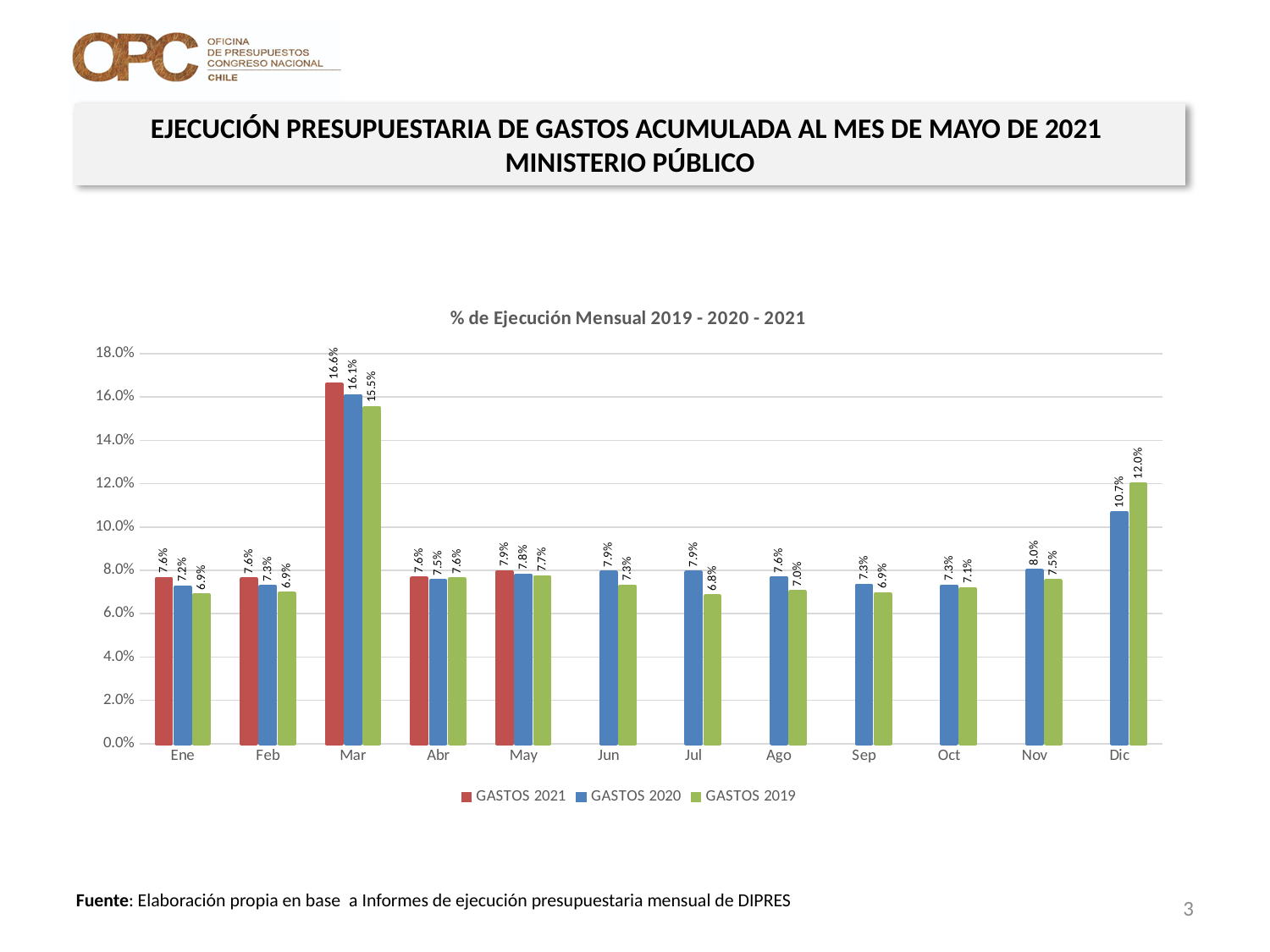
What is the value for GASTOS 2020 in Nov? 8.0% What is the difference between GASTOS 2021 and GASTOS 2019 in Mar? 1.1% Which month has the lowest value for GASTOS 2019? Jul What is the title of the chart? % de Ejecución Mensual 2019 - 2020 - 2021 What is the value for GASTOS 2019 in Dic? 12.0% What is the value for GASTOS 2021 in Mar? 16.6% Is the value for GASTOS 2020 in Dic greater or less than 10.0%? greater Which month has the highest value for GASTOS 2020? Mar Which is larger in Dic, GASTOS 2020 or GASTOS 2019? GASTOS 2019 How many series does the legend list? 3 How many months are shown on the x axis? 12 What kind of chart is shown on the slide? Bar chart